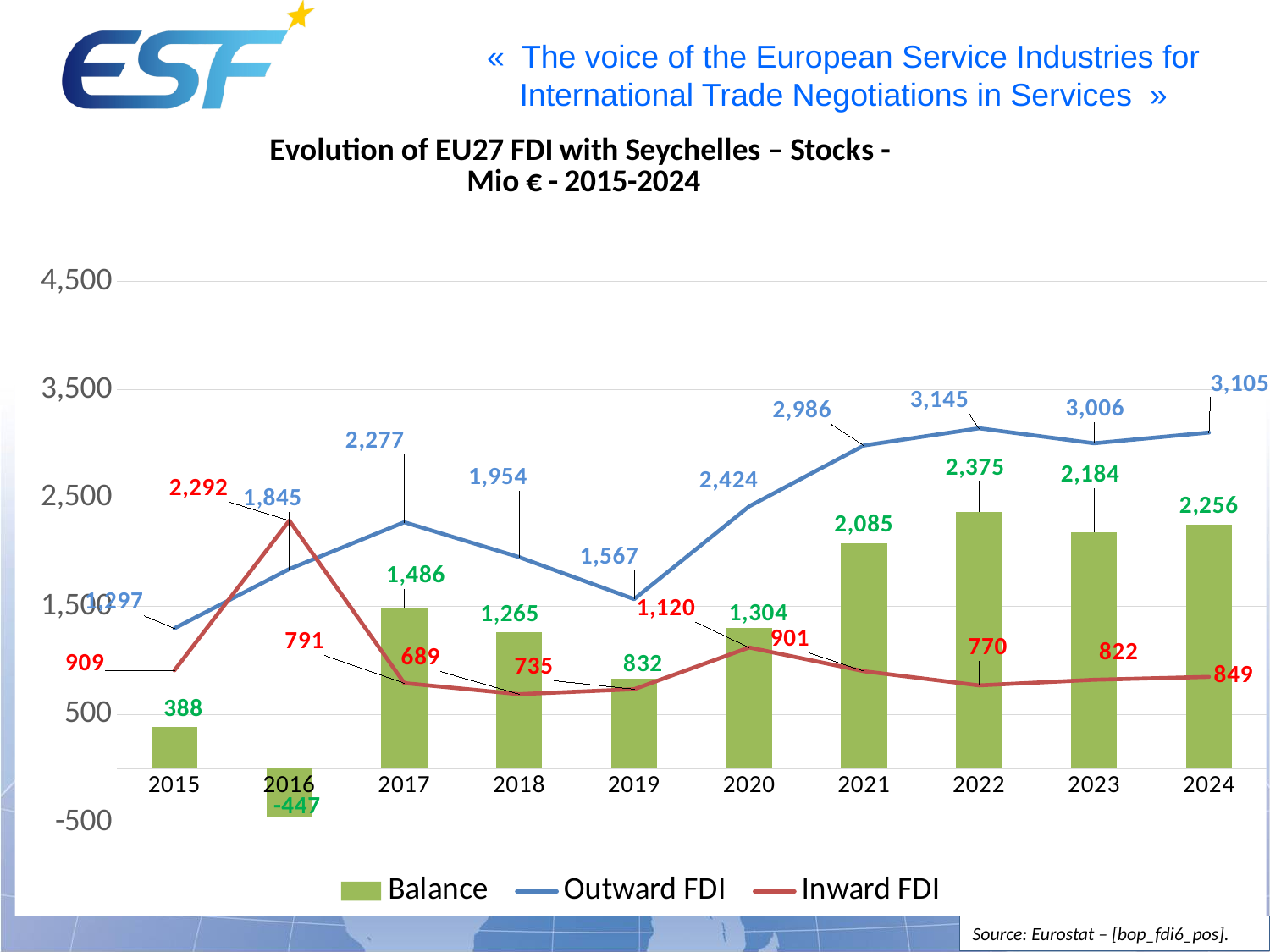
What is the Inward FDI value for 2016? 2,292 What is the difference between the Outward FDI values for 2024 and 2023? 99 In which year is the Balance highest? 2022 What kind of chart is shown on the slide? Combination bar and line chart In which year is the Balance lowest? 2016 What is the Balance value for 2019? 832 Is the Outward FDI value for 2021 greater or less than 2,500? greater What is the Outward FDI value for 2022? 3,145 How many series does the legend list? 3 In which year is Inward FDI highest? 2016 Which year has the larger Outward FDI value, 2017 or 2018? 2017 How many years are shown on the x axis? 10